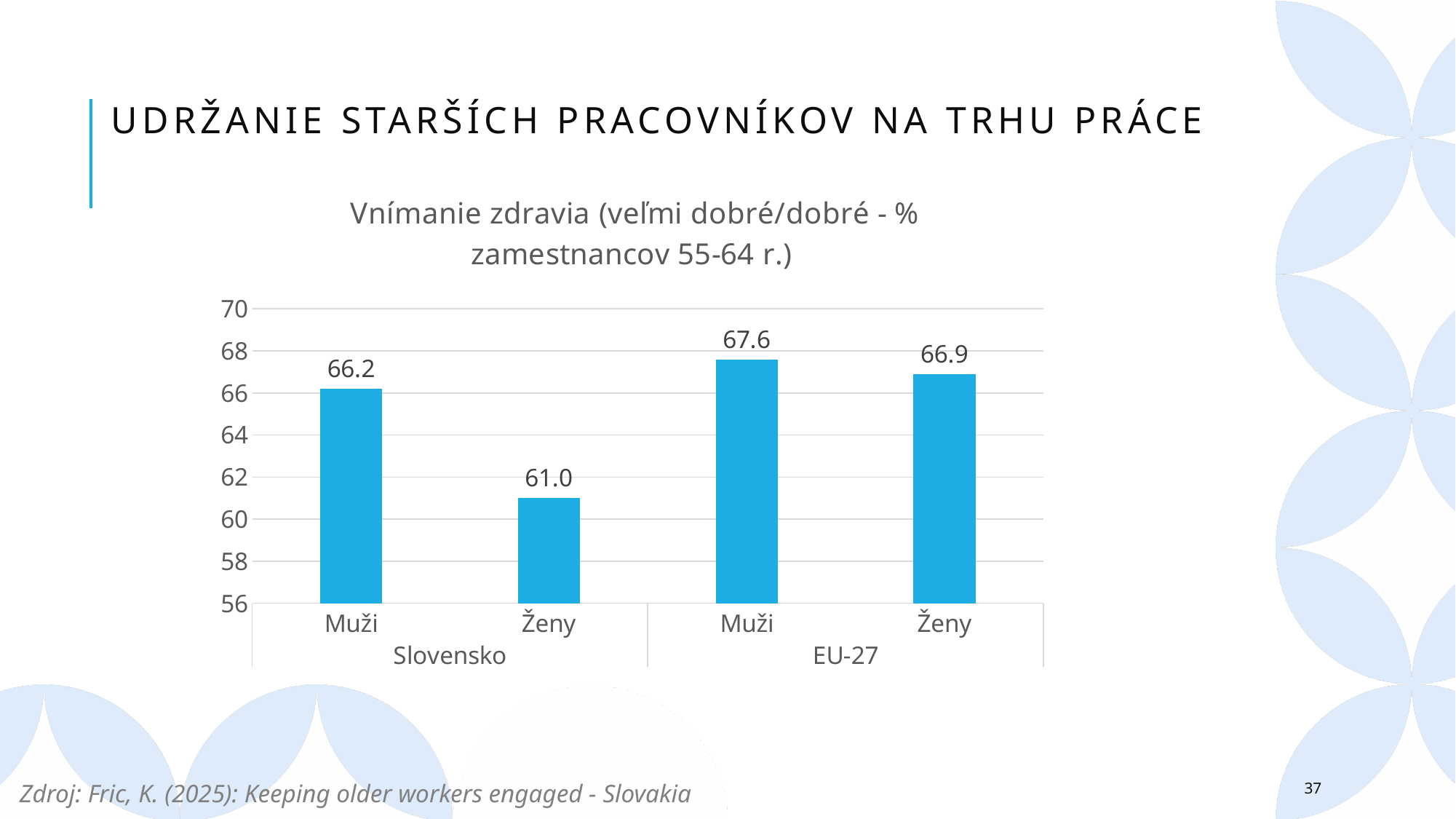
What type of chart is shown on the slide? Bar chart What is the difference between Ženy in EU-27 and Ženy in Slovensko? 5.9 How many bars are shown in the chart? 4 What is the difference between Muži and Ženy in Slovensko? 5.2 What is the value for Muži in Slovensko? 66.2 Is the value for Ženy in Slovensko greater or less than 62? less Which bar has the lowest value? Ženy, Slovensko Which is larger: Muži in Slovensko or Ženy in EU-27? Ženy in EU-27 What is the value for Ženy in EU-27? 66.9 What is the value for Muži in EU-27? 67.6 Which bar has the highest value? Muži, EU-27 What is the value for Ženy in Slovensko? 61.0